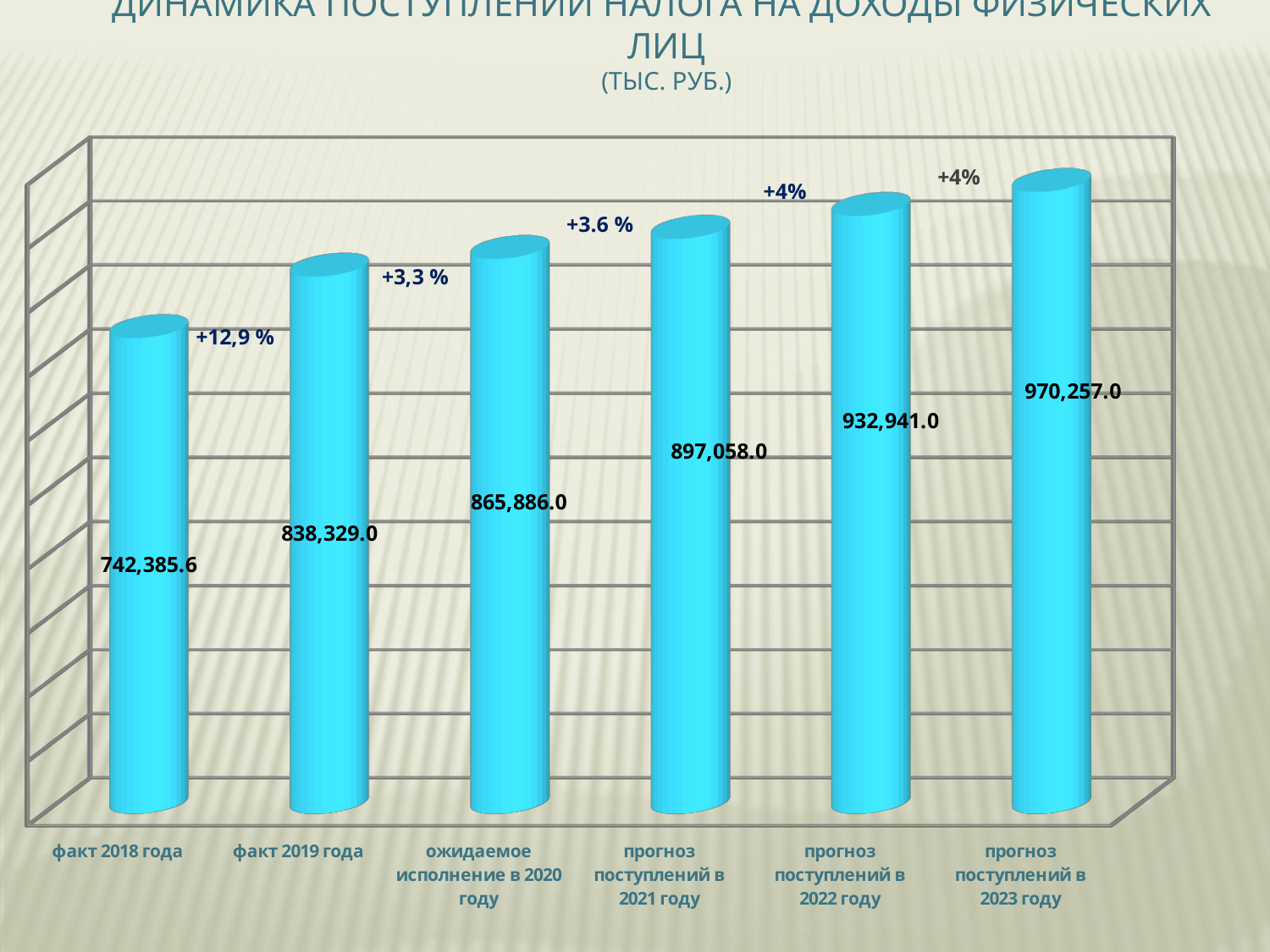
What is the difference between the values for факт 2019 года and факт 2018 года? 95,943.4 How many categories are shown on the chart? 6 Which is larger, the value for прогноз поступлений в 2021 году or the value for ожидаемое исполнение в 2020 году? прогноз поступлений в 2021 году What is the difference between the values for прогноз поступлений в 2023 году and прогноз поступлений в 2022 году? 37,316.0 What is the value for прогноз поступлений в 2023 году? 970,257.0 What is the value for факт 2019 года? 838,329.0 What kind of chart is shown on the slide? bar chart Do the values rise or fall from left to right along the x axis? rise Which category has the highest value? прогноз поступлений в 2023 году Which category has the lowest value? факт 2018 года What is the value for ожидаемое исполнение в 2020 году? 865,886.0 What is the value for факт 2018 года? 742,385.6